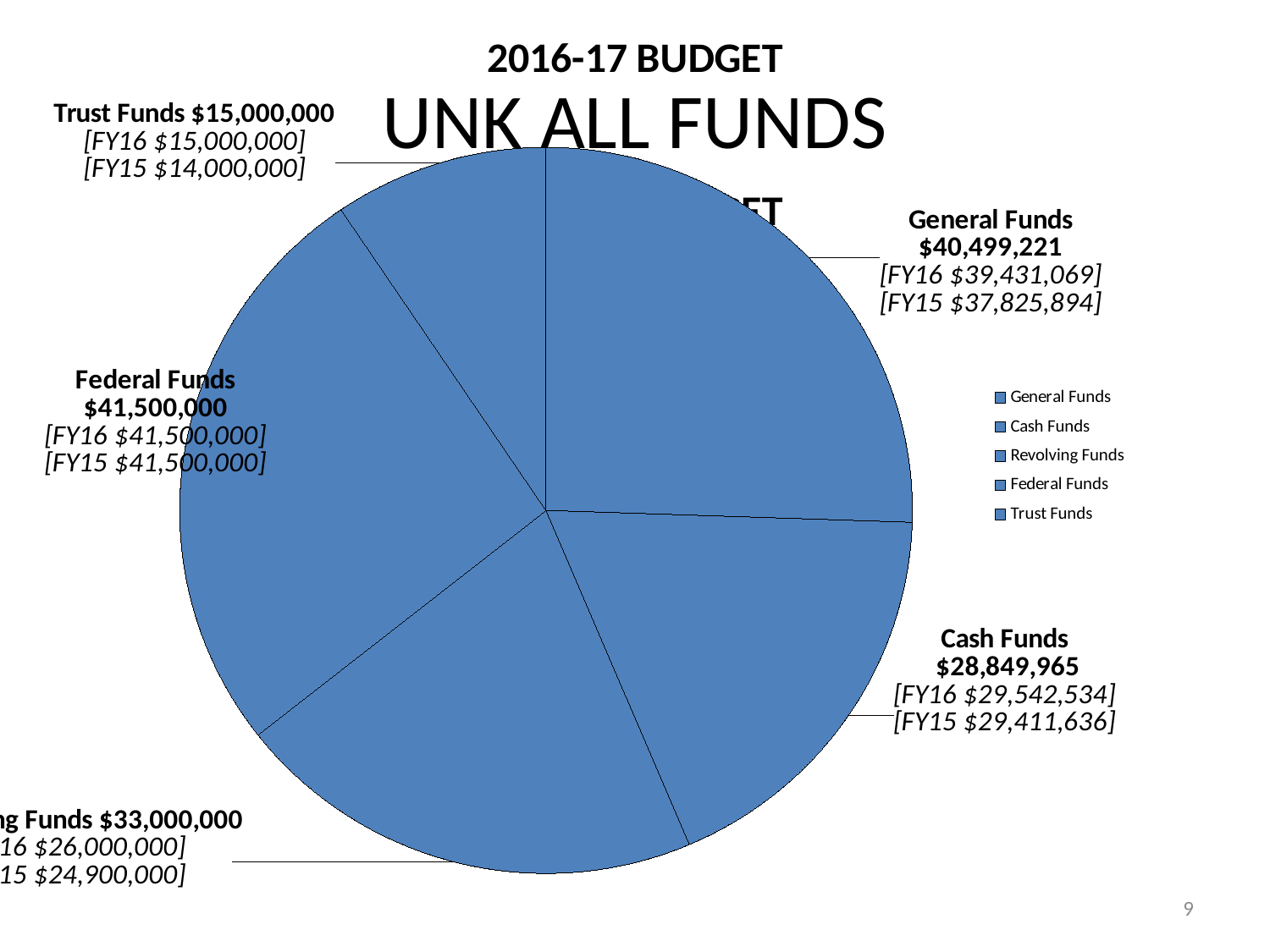
What is the 2016-17 value for Trust Funds? $15,000,000 Which is larger, Cash Funds or Revolving Funds? Revolving Funds How many slices does the pie chart have? 5 How many entries does the legend list? 5 What is the 2016-17 value for General Funds? $40,499,221 What is the 2016-17 value for Federal Funds? $41,500,000 What is the difference between the Federal Funds and Trust Funds values? $26,500,000 Which fund category has the smallest slice of the pie? Trust Funds What kind of chart is shown on the slide? Pie chart What is the 2016-17 value for Cash Funds? $28,849,965 What was the FY16 value for General Funds shown in the label? $39,431,069 Which fund category has the largest 2016-17 value? Federal Funds